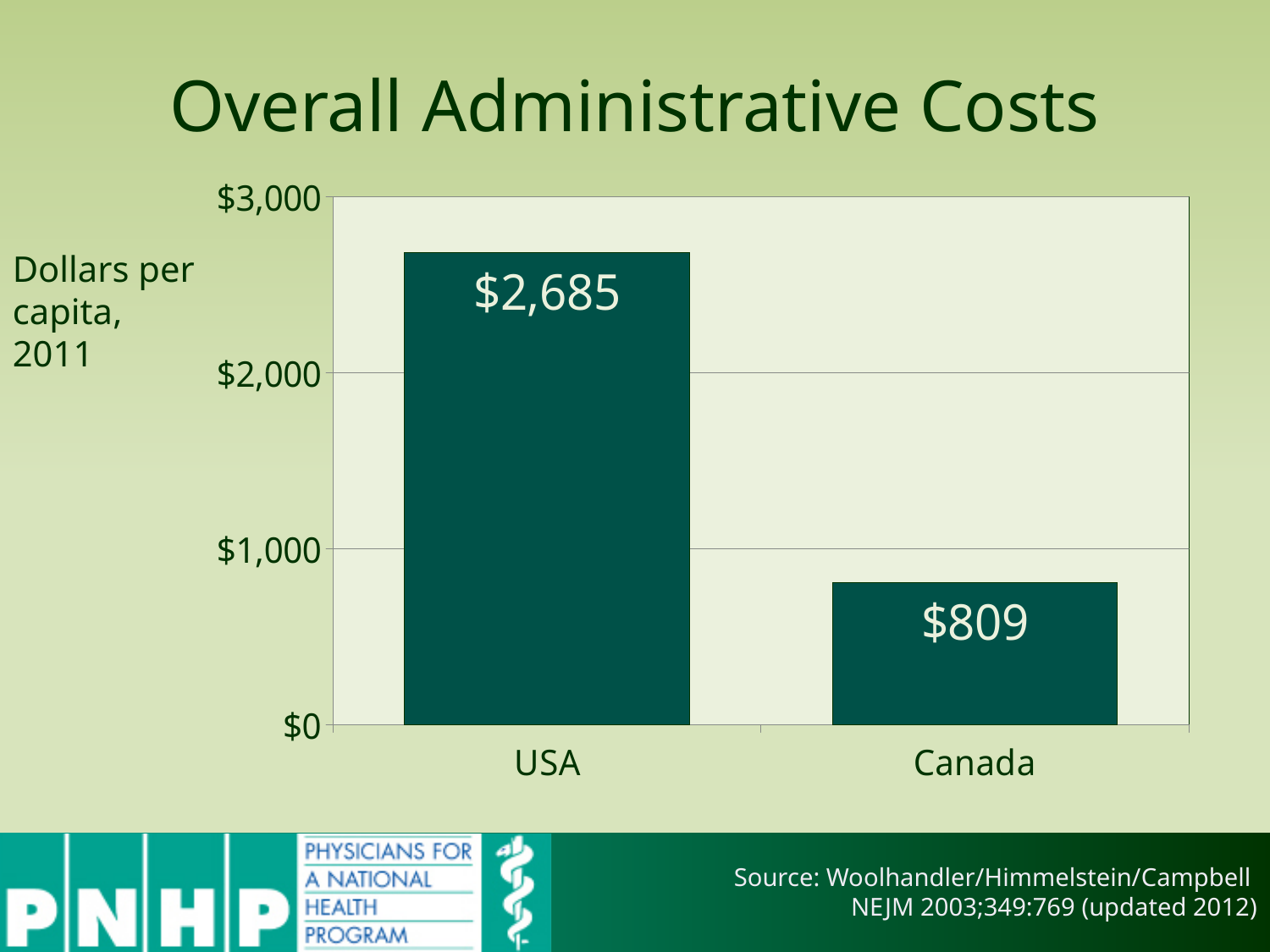
How many categories are shown in the chart? 2 What is the value for Canada? $809 What unit is the y axis measured in, according to the label on the slide? Dollars per capita, 2011 Which category has the highest value? USA Which is larger, the value for USA or the value for Canada? USA Which category has the lowest value? Canada What is the title of the chart? Overall Administrative Costs Is the value for USA greater or less than $2,000? greater What is the value for USA? $2,685 What is the difference between the values for USA and Canada? $1,876 What kind of chart is shown on the slide? bar chart Is the value for Canada greater or less than $1,000? less